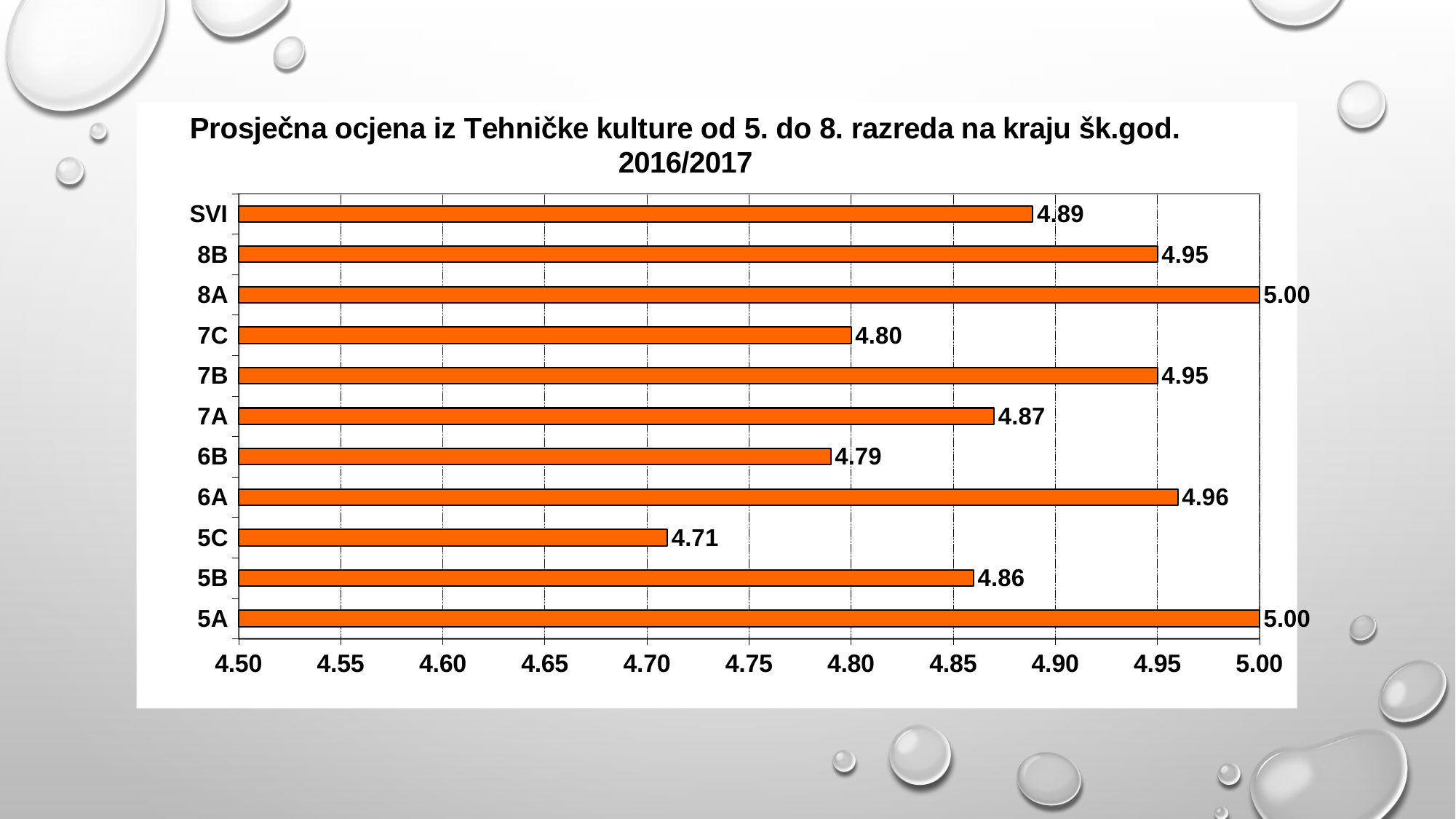
What is the title of the chart? Prosječna ocjena iz Tehničke kulture od 5. do 8. razreda na kraju šk.god. 2016/2017 What is the difference between the values for 8A and 7C? 0.20 Which is larger, the value for 7A or the value for 5B? 7A How many categories are shown on the chart? 11 Which categories share the highest value of 5.00? 5A and 8A What is the value for SVI? 4.89 What kind of chart is this? bar chart What is the value for 7C? 4.80 What is the value for 5C? 4.71 What is the value for 6A? 4.96 What is the difference between the values for 6A and 6B? 0.17 Which category has the lowest value? 5C